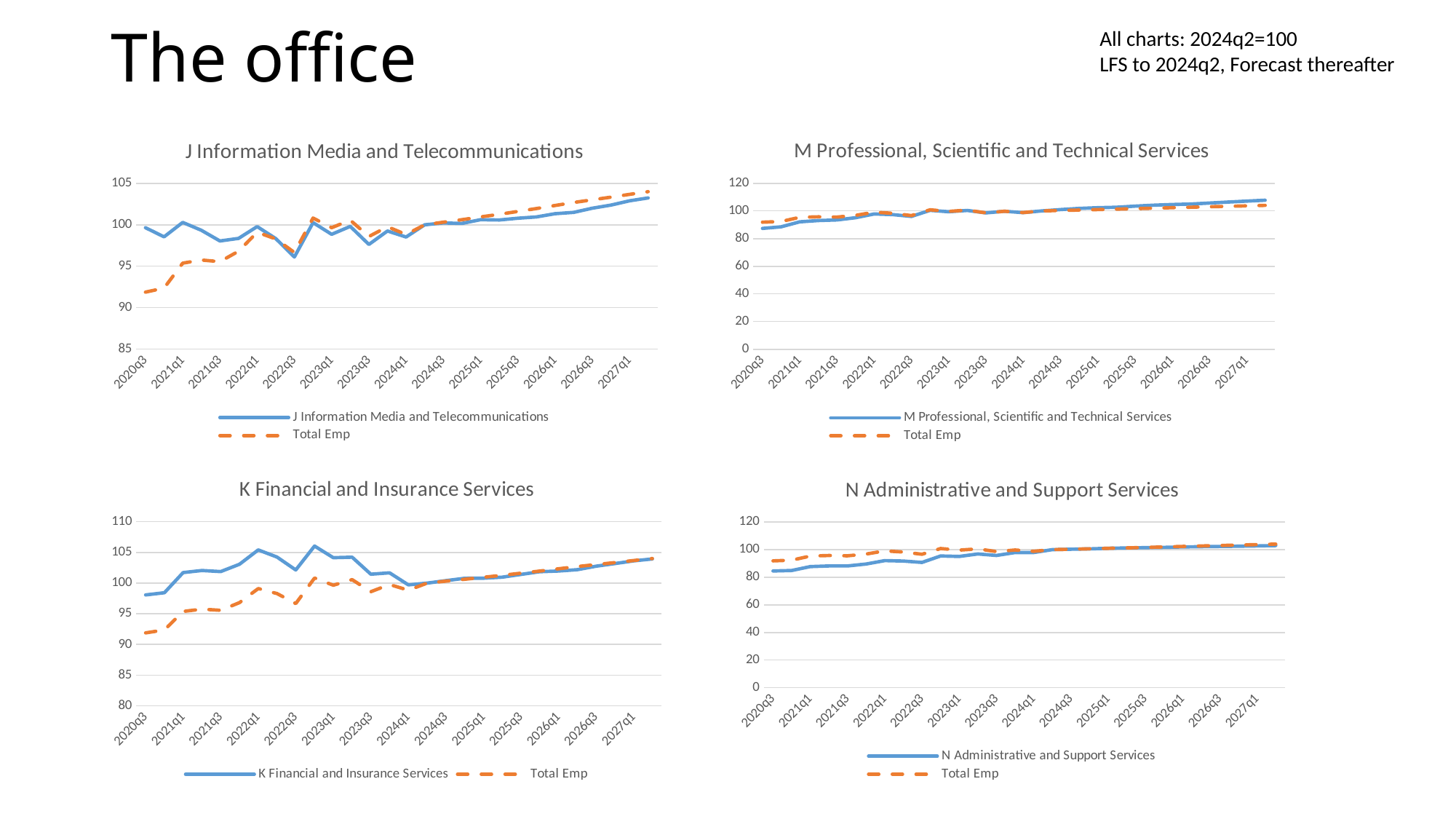
In the 'J Information Media and Telecommunications' chart, is the value for Total Emp at 2020q3 greater or less than 95? less In the 'J Information Media and Telecommunications' chart, how many series does the legend list? 2 In the 'N Administrative and Support Services' chart, does the Total Emp series rise or fall from 2024q3 to 2027q1? rises In the 'M Professional, Scientific and Technical Services' chart, is the value for M Professional, Scientific and Technical Services at 2020q3 greater or less than 100? less What kind of chart is 'J Information Media and Telecommunications'? Line chart In the 'M Professional, Scientific and Technical Services' chart, does the M Professional, Scientific and Technical Services series rise or fall from 2020q3 to 2027q1? rises In the 'K Financial and Insurance Services' chart, is the value for K Financial and Insurance Services at 2023q1 greater or less than 100? greater In the 'J Information Media and Telecommunications' chart, which series is higher at 2020q3, J Information Media and Telecommunications or Total Emp? J Information Media and Telecommunications In the 'K Financial and Insurance Services' chart, which series is higher at 2022q1, K Financial and Insurance Services or Total Emp? K Financial and Insurance Services What is the title of the bottom-left chart? K Financial and Insurance Services What are the legend entries in the 'N Administrative and Support Services' chart? N Administrative and Support Services; Total Emp